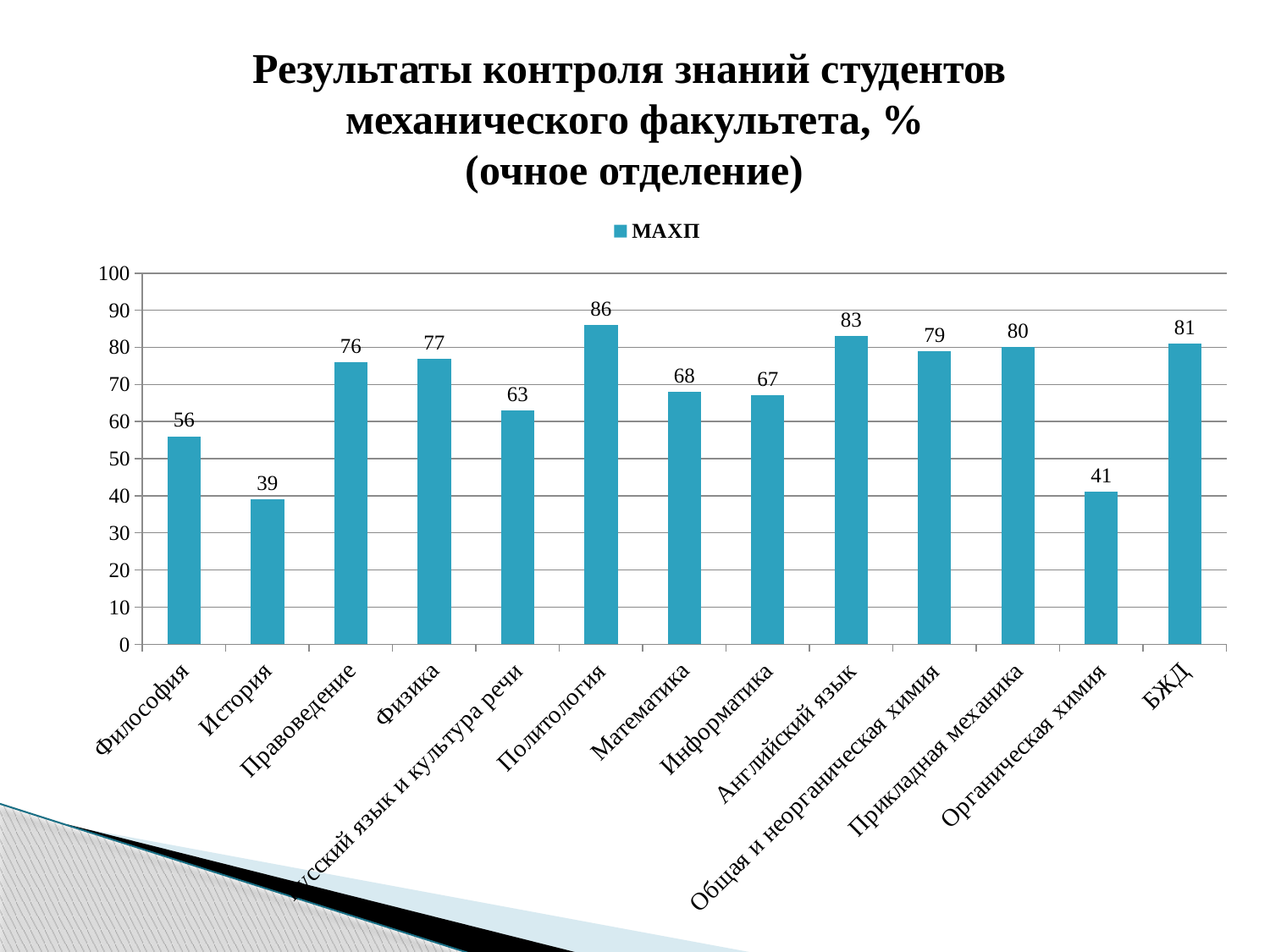
What is the difference between the values for Политология and История? 47 What kind of chart is shown on the slide? bar chart Is the value for Прикладная механика greater or less than 70? greater What is the difference between the values for БЖД and Органическая химия? 40 Which is larger, the value for Философия or the value for Математика? Математика Which category has the lowest value? История How many categories are shown on the x axis? 13 What is the value for История? 39 What is the value for Политология? 86 Which category has the highest value? Политология What is the value for Английский язык? 83 How many series does the legend list? 1